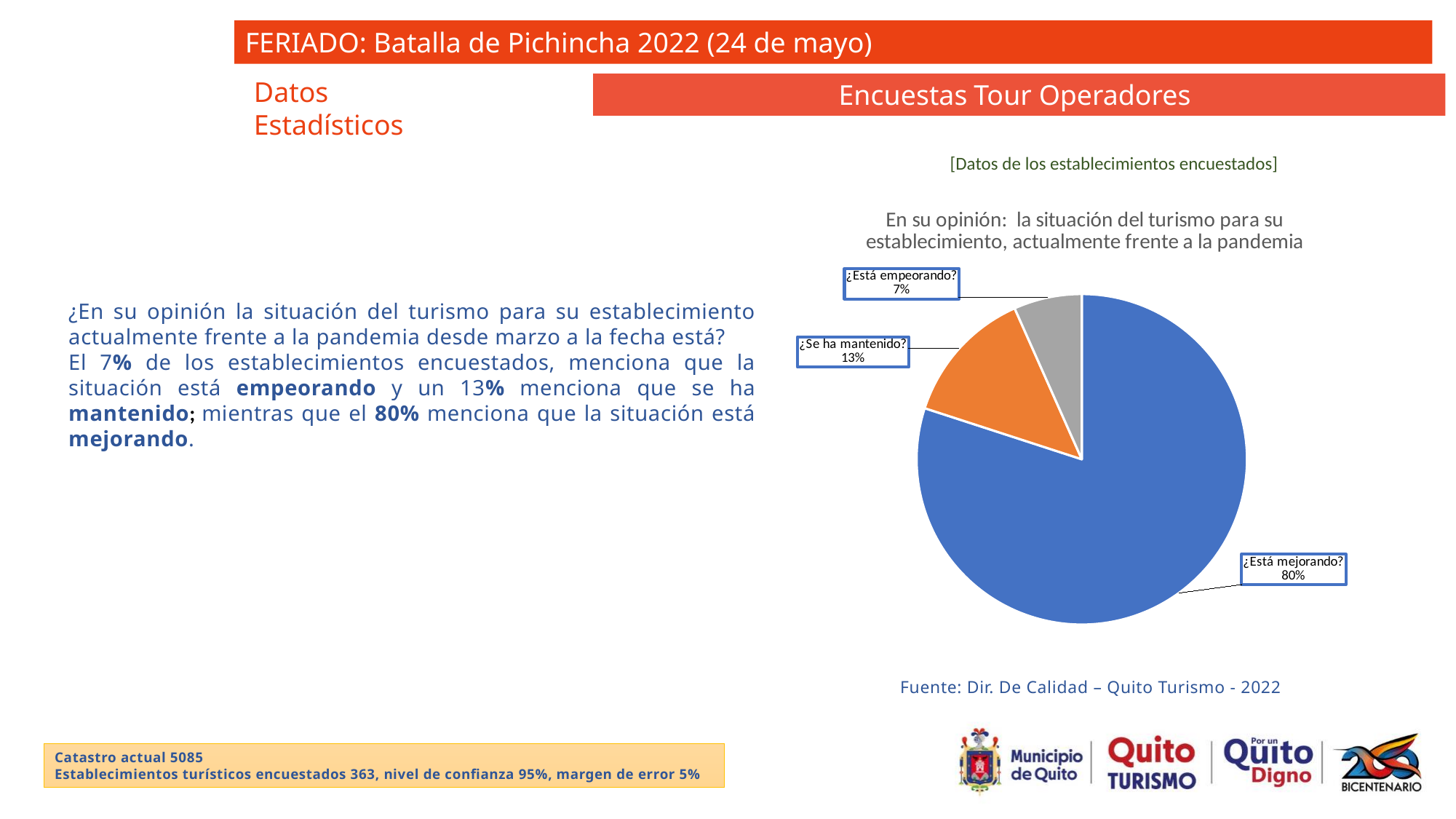
What percentage of surveyed establishments say the situation has stayed the same (¿Se ha mantenido?)? 13% What percentage of surveyed establishments say the situation is getting worse (¿Está empeorando?)? 7% What percentage of surveyed establishments say the situation is improving (¿Está mejorando?)? 80% Which response has the smallest share of the pie? ¿Está empeorando? What is the difference in percentage points between ¿Está mejorando? and ¿Se ha mantenido?? 67 Which is larger: the share for ¿Se ha mantenido? or the share for ¿Está empeorando?? ¿Se ha mantenido? What colour is the slice for ¿Está mejorando?? Blue Which response has the largest share of the pie? ¿Está mejorando? What kind of chart is shown on the slide? Pie chart How many slices does the pie chart have? 3 What is the difference in percentage points between ¿Se ha mantenido? and ¿Está empeorando?? 6 What colour is the slice for ¿Se ha mantenido?? Orange